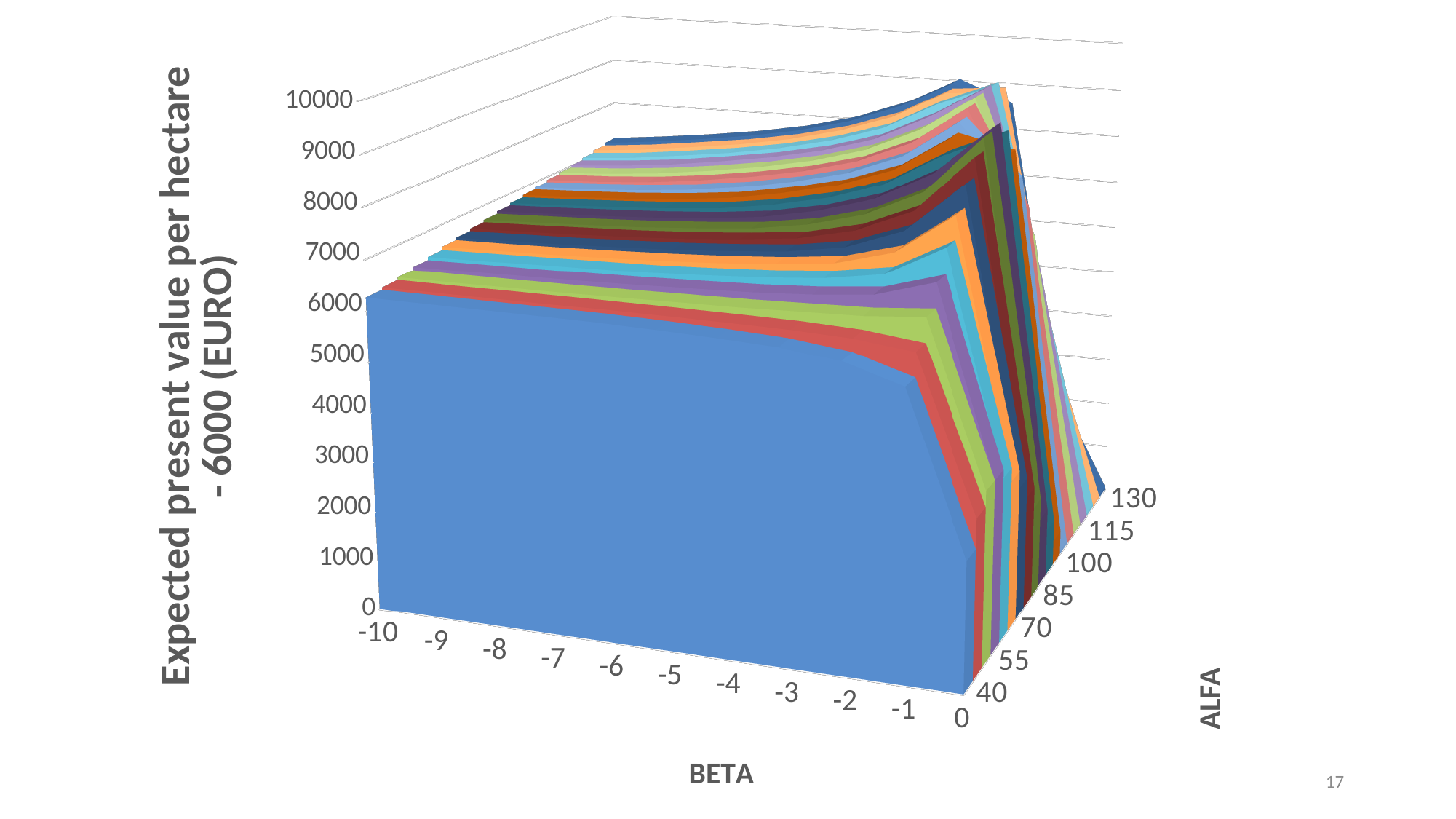
What is the highest BETA value labelled on the chart's front axis? 0 What is the title of the horizontal (front) axis of the chart? BETA What is the maximum value shown on the chart's vertical axis? 10000 What is the lowest ALFA value labelled on the chart's depth axis? 40 What is the highest ALFA value labelled on the chart's depth axis? 130 What is the lowest BETA value labelled on the chart's front axis? -10 How many BETA values are labelled along the front axis of the chart? 11 How many ALFA values are labelled along the depth axis of the chart? 7 What kind of chart is shown on the slide? 3D area chart What is the step between consecutive ALFA labels on the depth axis? 15 What is the title of the depth axis of the chart? ALFA